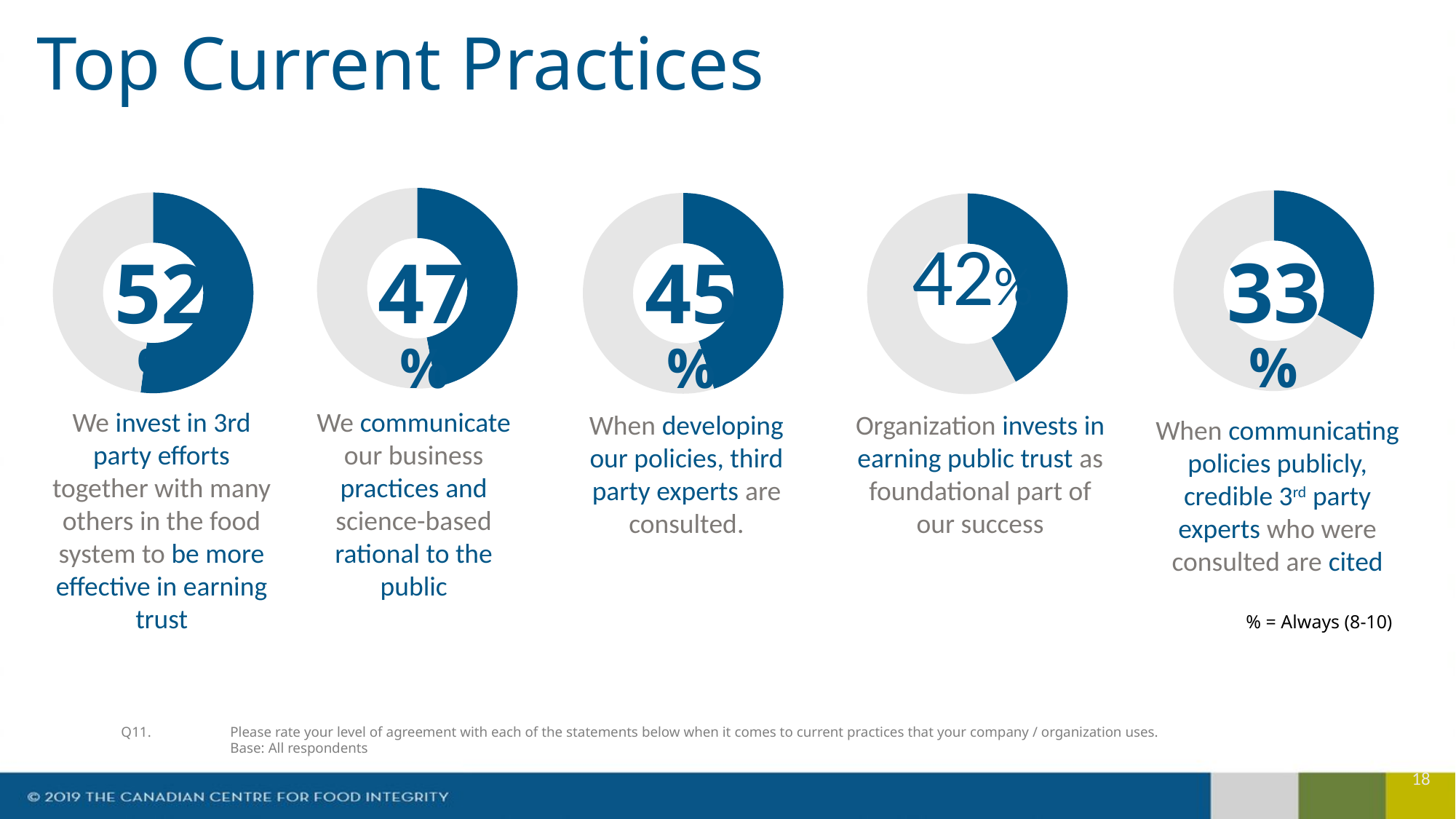
Which practice has the highest percentage on the slide? We invest in 3rd party efforts together with many others in the food system to be more effective in earning trust Which practice has the lowest percentage on the slide? When communicating policies publicly, credible 3rd party experts who were consulted are cited What percentage is shown in the donut chart for 'Organization invests in earning public trust as foundational part of our success'? 42% What percentage is shown in the donut chart for 'When developing our policies, third party experts are consulted'? 45% What kind of chart is used to display each percentage on the slide? Donut (pie) chart How many donut charts are shown on the slide? 5 Which is larger: the percentage for communicating business practices and science-based rational to the public, or the percentage for consulting third party experts when developing policies? Communicating business practices and science-based rational to the public (47%) Do the percentages rise or fall moving from the leftmost donut chart to the rightmost? Fall What percentage is shown in the donut chart for 'We invest in 3rd party efforts together with many others in the food system to be more effective in earning trust'? 52% What percentage is shown in the donut chart for 'When communicating policies publicly, credible 3rd party experts who were consulted are cited'? 33% What percentage is shown in the donut chart for 'We communicate our business practices and science-based rational to the public'? 47% What is the difference in percentage points between the highest donut chart (52%) and the lowest donut chart (33%)? 19 percentage points